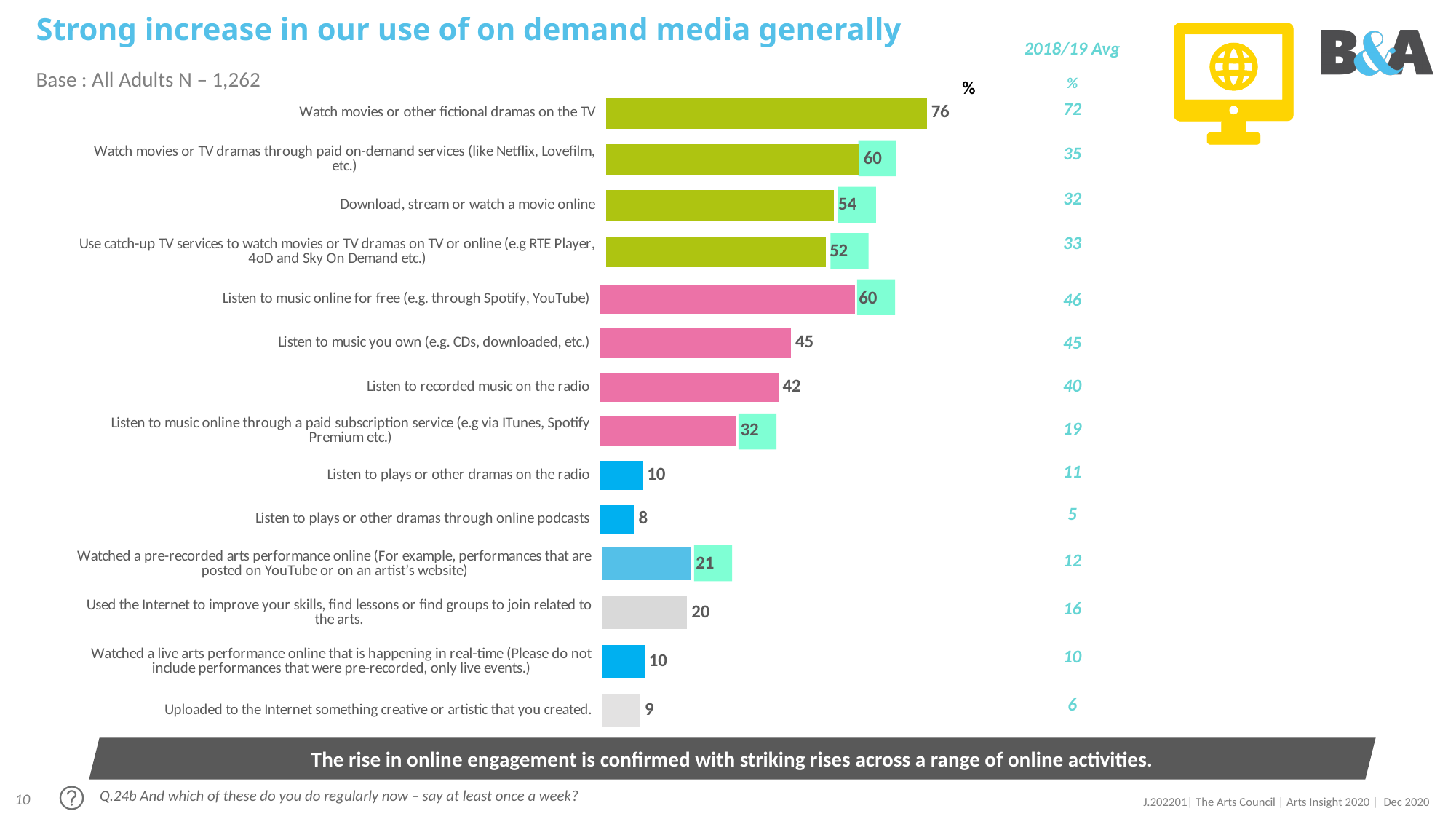
What is the 2018/19 Avg value shown for 'Listen to music online for free (e.g. through Spotify, YouTube)'? 46 Which category has the highest value in the chart? Watch movies or other fictional dramas on the TV Which is larger: the value for 'Listen to music you own' or 'Listen to recorded music on the radio'? Listen to music you own What is the difference between the current value and the 2018/19 Avg for 'Watch movies or TV dramas through paid on-demand services'? 25 What is the value for 'Watched a pre-recorded arts performance online'? 21 What is the difference between the values for 'Watch movies or TV dramas through paid on-demand services' and 'Download, stream or watch a movie online'? 6 What is the base stated for the chart? All Adults N – 1,262 What kind of chart is shown on the slide? Bar chart What is the value for 'Listen to music online through a paid subscription service (e.g via ITunes, Spotify Premium etc.)'? 32 Which category has the lowest value in the chart? Listen to plays or other dramas through online podcasts What is the value for 'Watch movies or other fictional dramas on the TV'? 76 How many categories are plotted in the chart? 14